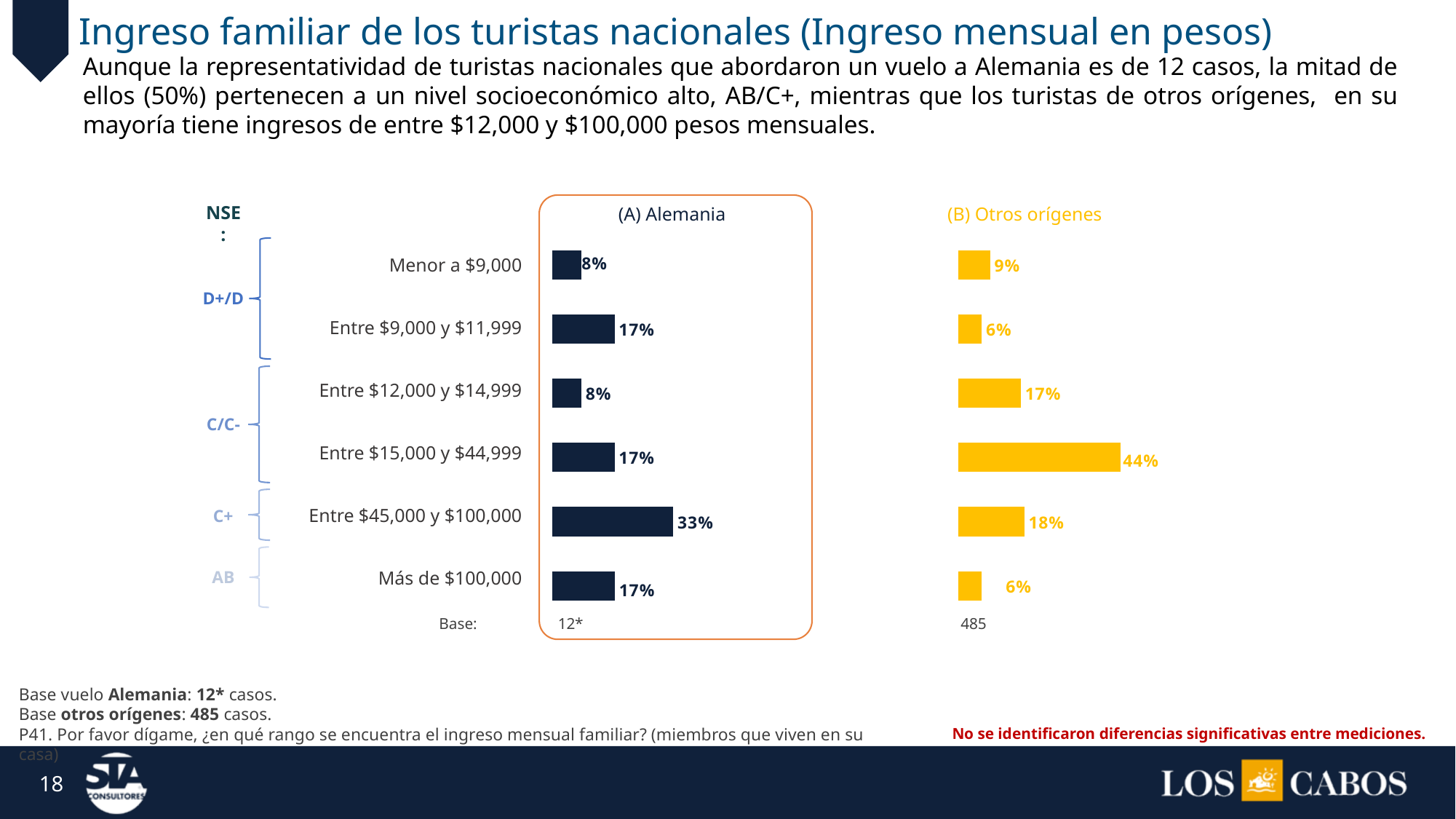
In the (B) Otros orígenes chart, what is the difference between 'Entre $15,000 y $44,999' and 'Entre $45,000 y $100,000'? 26% How many income categories are shown in the (A) Alemania chart? 6 In the (A) Alemania chart, which income category has the highest value? Entre $45,000 y $100,000 In the (B) Otros orígenes chart, which income category has the highest value? Entre $15,000 y $44,999 What is the base (number of cases) shown for the (B) Otros orígenes chart? 485 In the (A) Alemania chart, what is the value for 'Entre $45,000 y $100,000'? 33% What colour are the bars in the (A) Alemania chart? Dark navy blue In the (A) Alemania chart, what is the value for 'Menor a $9,000'? 8% What kind of chart is used for (B) Otros orígenes? Bar chart For 'Entre $9,000 y $11,999', which chart shows the larger value, (A) Alemania or (B) Otros orígenes? (A) Alemania In the (B) Otros orígenes chart, what is the value for 'Más de $100,000'? 6% In the (B) Otros orígenes chart, what is the value for 'Entre $15,000 y $44,999'? 44%